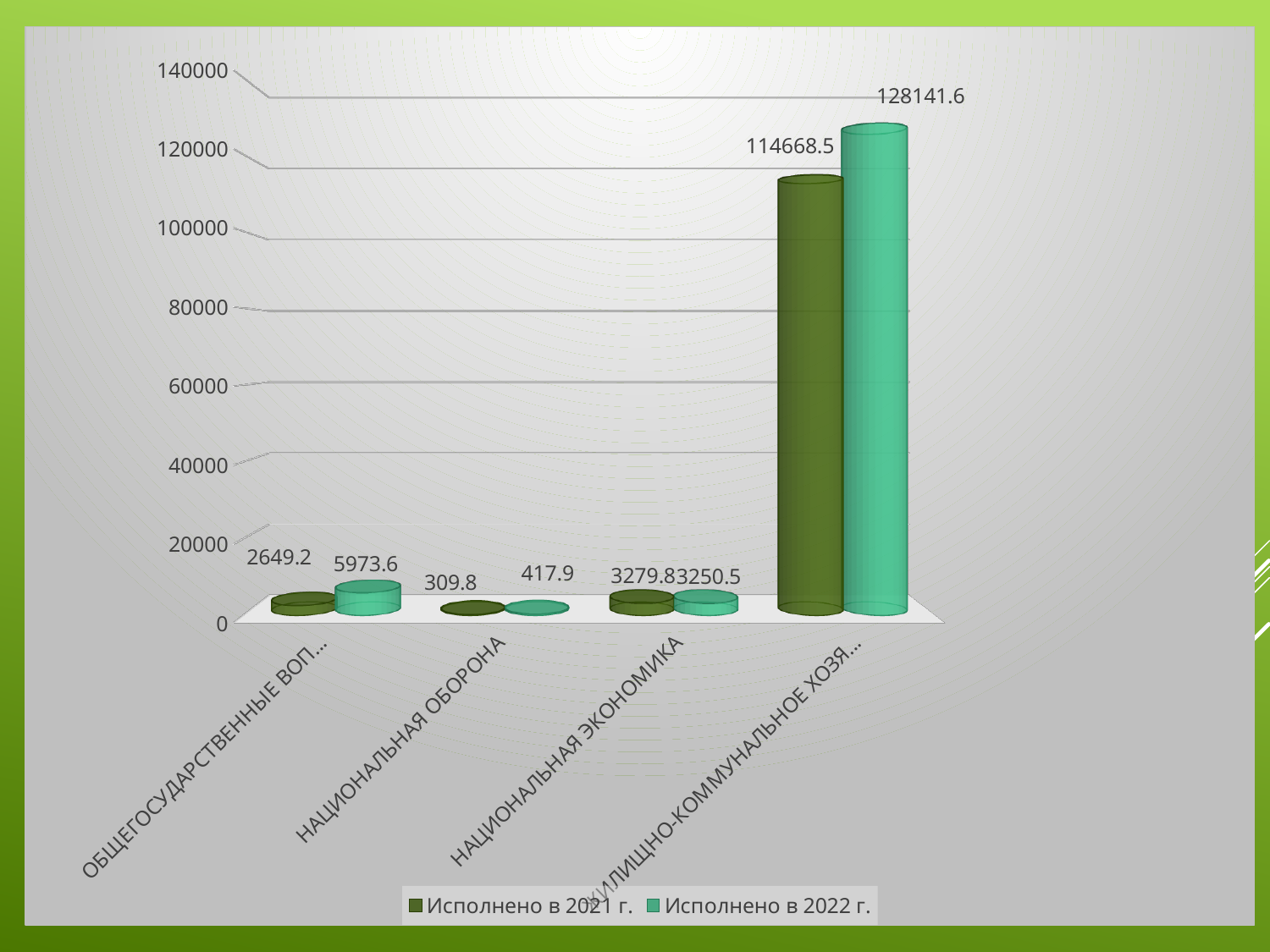
What is the value for НАЦИОНАЛЬНАЯ ОБОРОНА in the series Исполнено в 2021 г.? 309.8 How many series does the legend list? 2 How many categories are shown on the x axis? 4 What is the value for НАЦИОНАЛЬНАЯ ОБОРОНА in the series Исполнено в 2022 г.? 417.9 What is the difference between the Исполнено в 2022 г. and Исполнено в 2021 г. values for the rightmost category (ЖИЛИЩНО-КОММУНАЛЬНОЕ ХОЗЯ...)? 13473.1 What is the value for НАЦИОНАЛЬНАЯ ЭКОНОМИКА in the series Исполнено в 2021 г.? 3279.8 What is the value for НАЦИОНАЛЬНАЯ ЭКОНОМИКА in the series Исполнено в 2022 г.? 3250.5 For the leftmost category (ОБЩЕГОСУДАРСТВЕННЫЕ ВОП...), which series has the larger value, Исполнено в 2021 г. or Исполнено в 2022 г.? Исполнено в 2022 г. Which category has the lowest value in the series Исполнено в 2022 г.? НАЦИОНАЛЬНАЯ ОБОРОНА What is the value of the Исполнено в 2022 г. bar for the rightmost category (ЖИЛИЩНО-КОММУНАЛЬНОЕ ХОЗЯ...)? 128141.6 Which category has the highest value in the series Исполнено в 2021 г.? ЖИЛИЩНО-КОММУНАЛЬНОЕ ХОЗЯ... What kind of chart is shown on the slide? bar chart